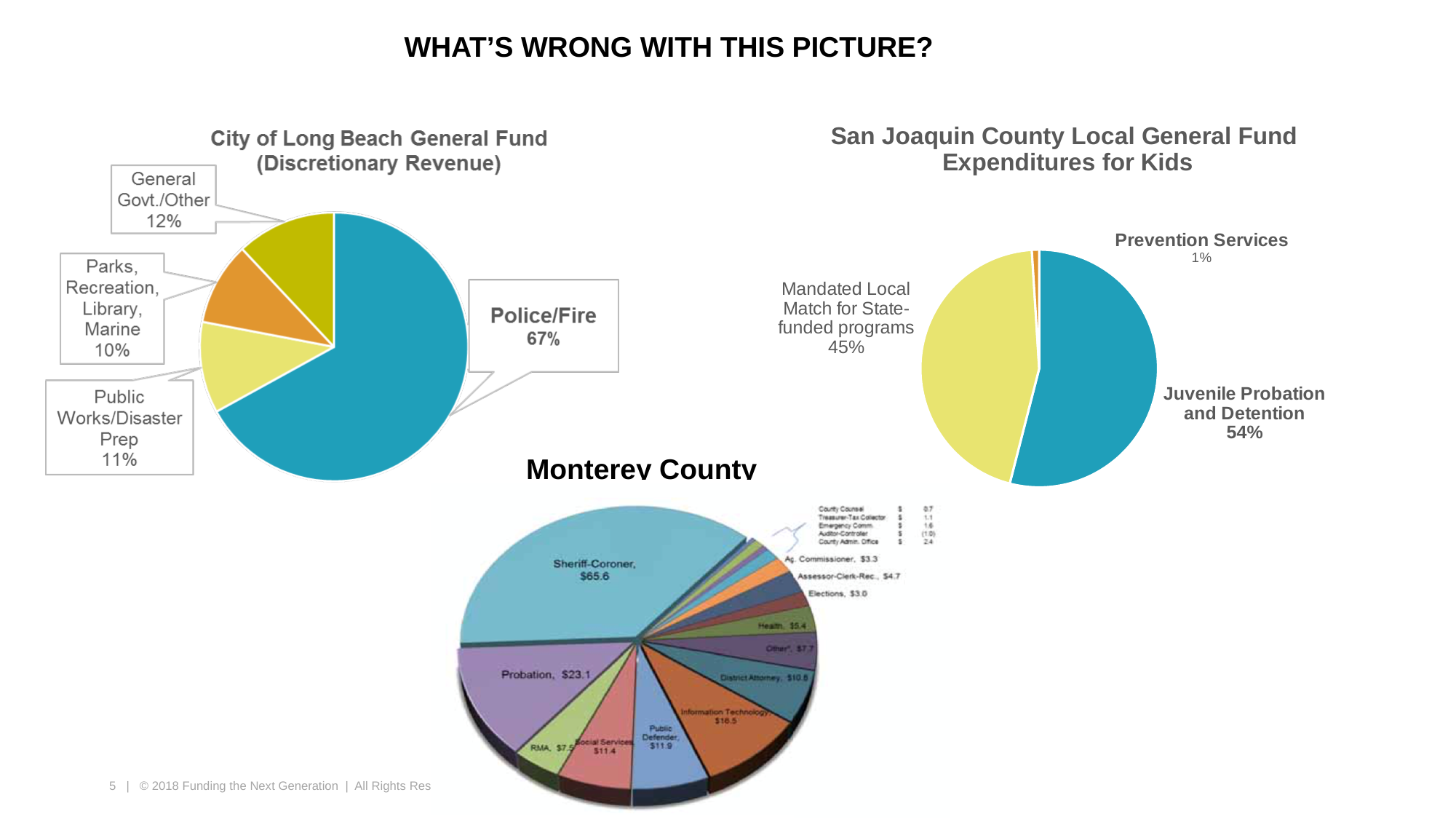
In the City of Long Beach General Fund (Discretionary Revenue) chart, what share does Police/Fire have? 67% In the City of Long Beach General Fund (Discretionary Revenue) chart, what is the difference between the Police/Fire share and the General Govt./Other share? 55% What kind of chart is the San Joaquin County Local General Fund Expenditures for Kids chart? Pie chart In the City of Long Beach General Fund (Discretionary Revenue) chart, which category has the smallest share? Parks, Recreation, Library, Marine In the San Joaquin County Local General Fund Expenditures for Kids chart, what share goes to Juvenile Probation and Detention? 54% In the City of Long Beach General Fund (Discretionary Revenue) chart, what share does Parks, Recreation, Library, Marine have? 10% In the City of Long Beach General Fund (Discretionary Revenue) chart, how many slices are there? 4 In the Monterey County chart, which category has the largest slice? Sheriff-Coroner In the Monterey County chart, what is the value for Sheriff-Coroner? $65.6 In the Monterey County chart, what is the value for Probation? $23.1 In the San Joaquin County Local General Fund Expenditures for Kids chart, which is larger: Mandated Local Match for State-funded programs or Juvenile Probation and Detention? Juvenile Probation and Detention